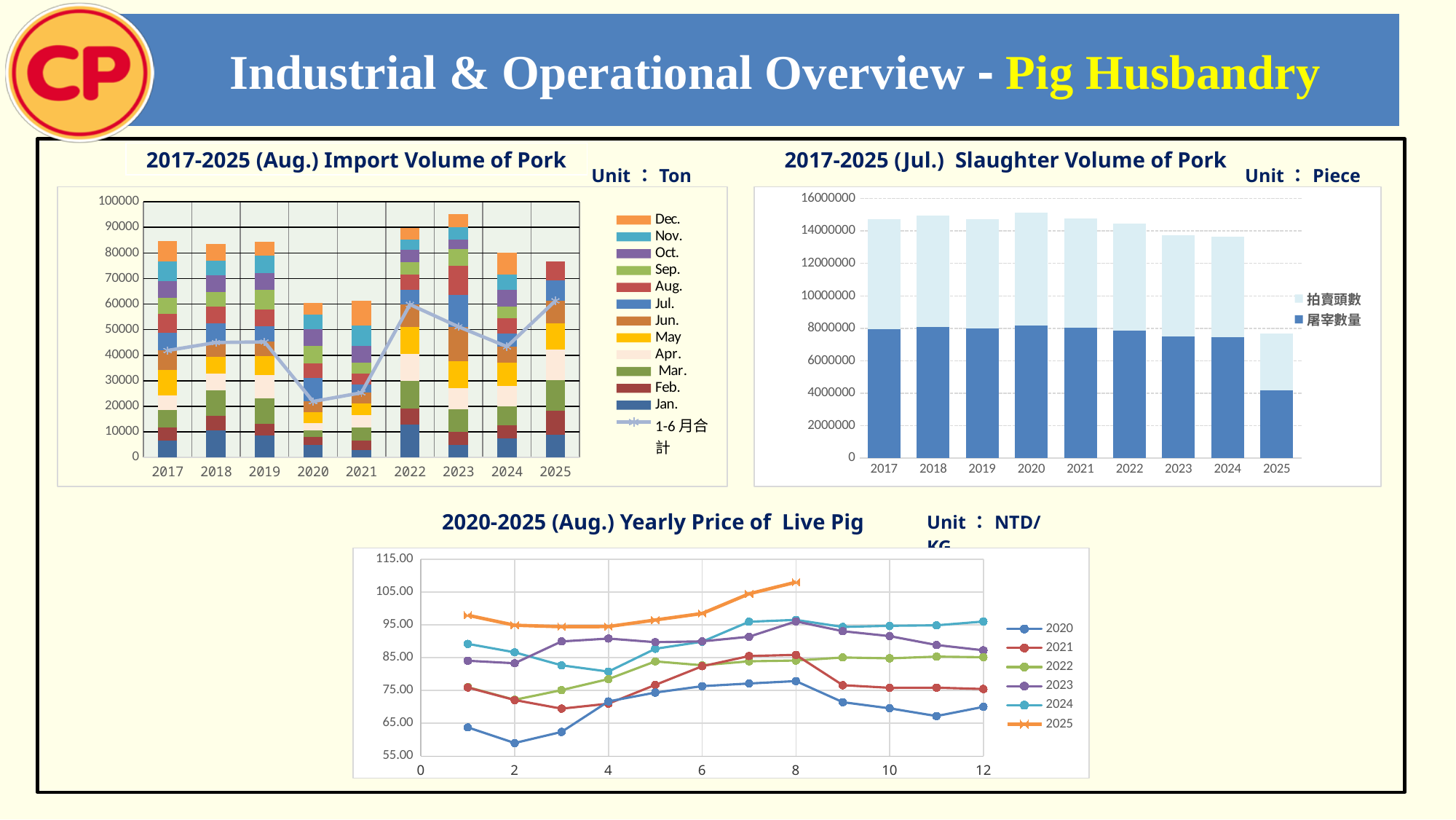
In the '2020-2025 (Aug.) Yearly Price of Live Pig' chart, is the 2025 value at month 8 greater or less than 105.00? greater In the '2017-2025 (Aug.) Import Volume of Pork' chart, is the total for 2023 greater or less than 90000? greater In the '2017-2025 (Aug.) Import Volume of Pork' chart, is the total for 2020 greater or less than 70000? less How many years are shown on the x axis of the '2017-2025 (Aug.) Import Volume of Pork' chart? 9 How many series does the legend of the '2017-2025 (Jul.) Slaughter Volume of Pork' chart list? 2 What type of chart is the '2017-2025 (Aug.) Import Volume of Pork' chart? stacked bar chart with a line In the '2017-2025 (Aug.) Import Volume of Pork' chart, which year has the highest total bar? 2023 In the '2020-2025 (Aug.) Yearly Price of Live Pig' chart, which is larger at month 1, the 2025 value or the 2020 value? 2025 What unit is stated for the '2017-2025 (Aug.) Import Volume of Pork' chart? Ton How many series does the legend of the '2020-2025 (Aug.) Yearly Price of Live Pig' chart list? 6 In the '2017-2025 (Jul.) Slaughter Volume of Pork' chart, which year has the lowest total bar? 2025